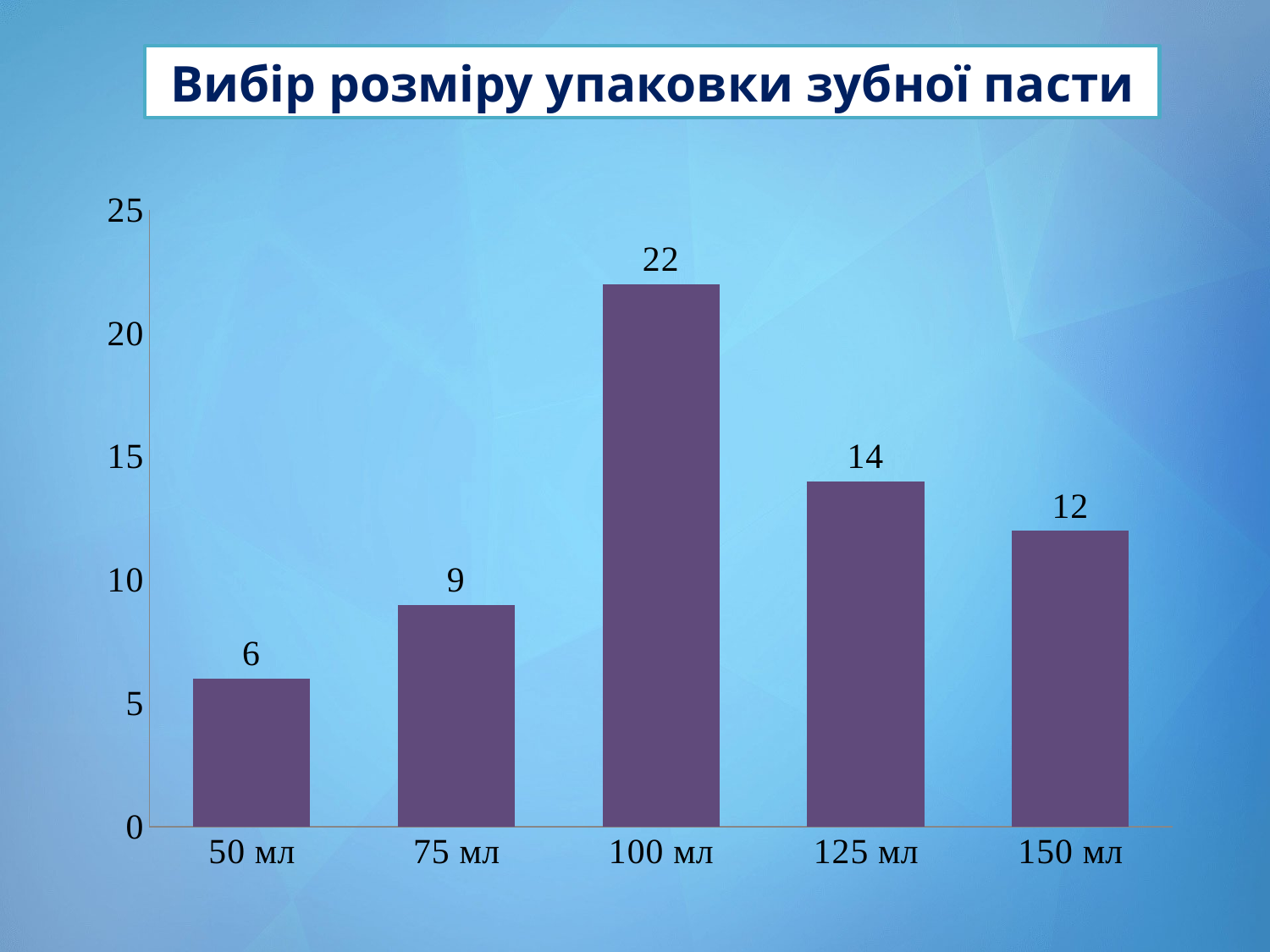
Is the value for 125 мл greater or less than 10? greater What is the title of the chart? Вибір розміру упаковки зубної пасти What is the difference between the values for 100 мл and 125 мл? 8 What is the value for 100 мл? 22 How many package sizes are shown on the chart? 5 What is the value for 50 мл? 6 What is the value for 150 мл? 12 Which is larger, the value for 75 мл or the value for 150 мл? 150 мл Which package size has the highest value? 100 мл What is the difference between the values for 75 мл and 50 мл? 3 What kind of chart is shown on the slide? bar chart Which package size has the lowest value? 50 мл